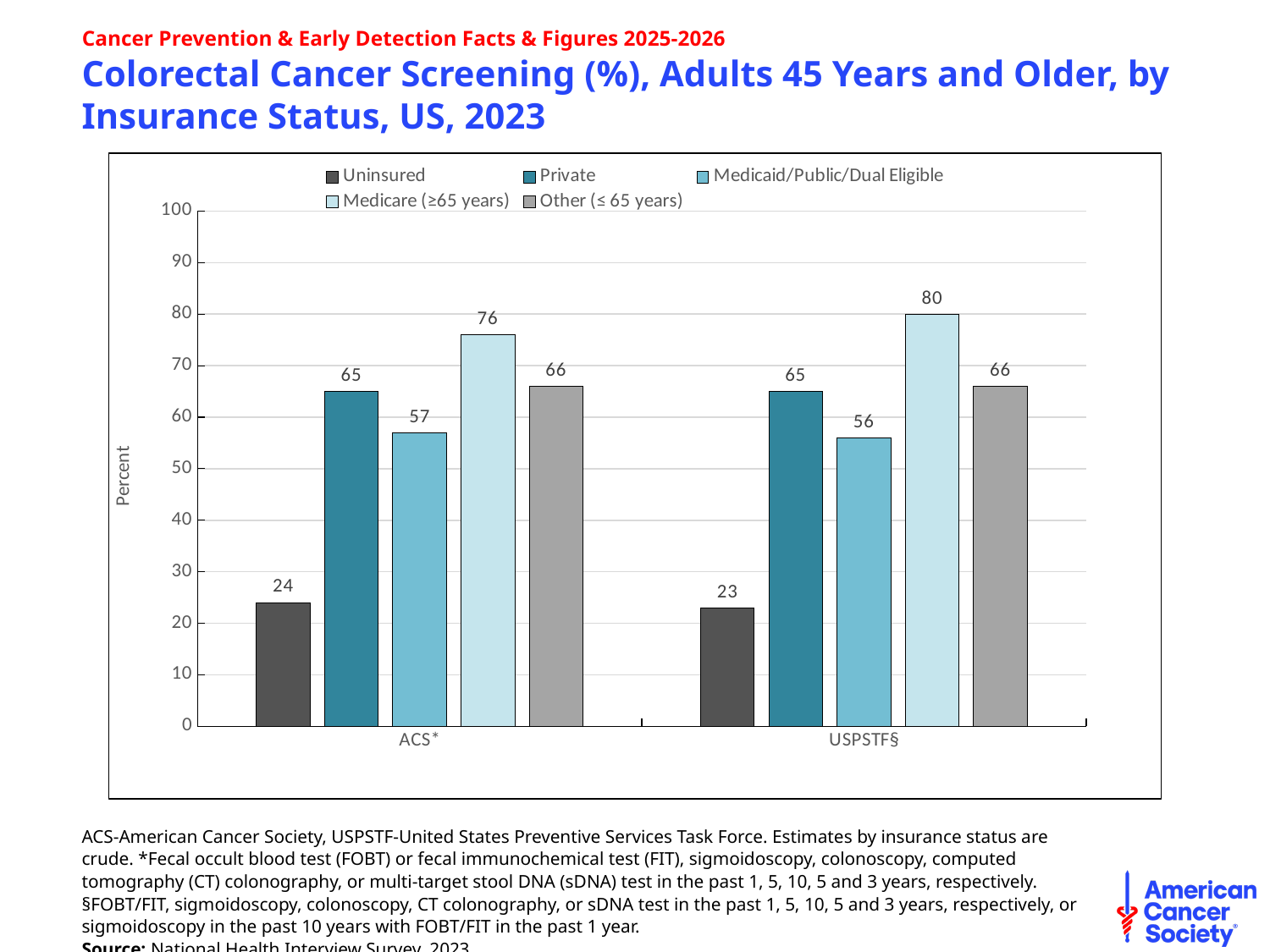
Which is larger under the ACS* guideline: the Private value or the Other (≤ 65 years) value? Other (≤ 65 years) What is the difference between the Medicare (≥65 years) value and the Uninsured value under the USPSTF§ guideline? 57 What kind of chart is shown on the slide? Bar chart What is the difference between the Private value and the Medicaid/Public/Dual Eligible value under the ACS* guideline? 8 What is the value for Medicaid/Public/Dual Eligible under the ACS* guideline? 57 What is the colorectal cancer screening percentage for Uninsured adults under the ACS* guideline? 24 How many series does the legend list? 5 What is the value for Medicare (≥65 years) under the USPSTF§ guideline? 80 What is the label on the vertical axis of the chart? Percent Which insurance group has the lowest screening percentage under the ACS* guideline? Uninsured Is the value for Uninsured under the USPSTF§ guideline greater or less than 30? less Which insurance group has the highest screening percentage under the USPSTF§ guideline? Medicare (≥65 years)